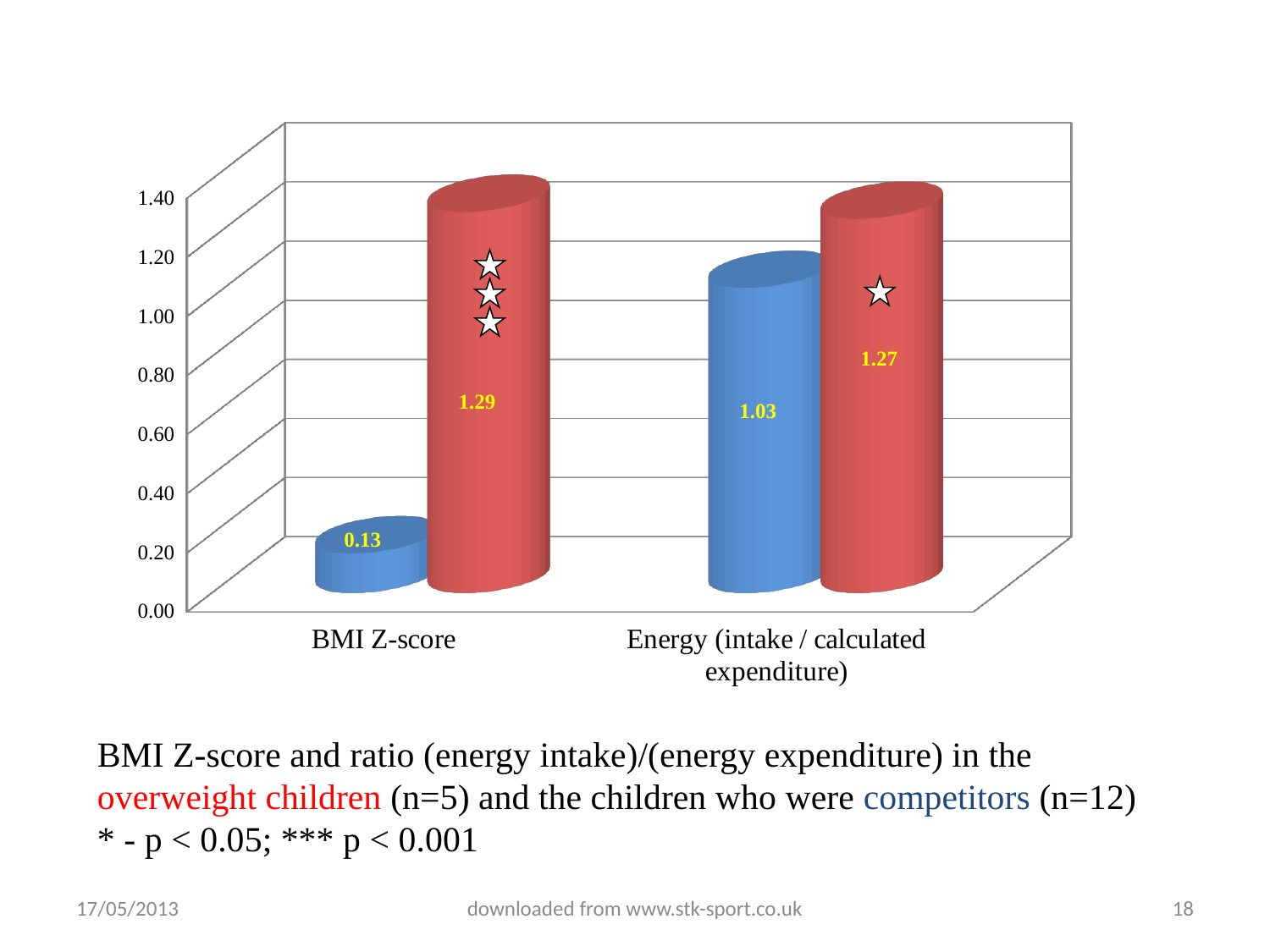
What is the value of the blue bar for BMI Z-score? 0.13 What is the value of the red bar for Energy (intake / calculated expenditure)? 1.27 What is the value of the red bar for BMI Z-score? 1.29 How many stars are drawn above the red bar for BMI Z-score? 3 How many categories are shown on the x axis? 2 What kind of chart is shown on the slide? Bar chart What is the difference between the red bar and the blue bar for Energy (intake / calculated expenditure)? 0.24 What is the difference between the red bar and the blue bar for BMI Z-score? 1.16 For BMI Z-score, which bar is larger, the blue bar or the red bar? The red bar Which bar has the lowest value in the chart? The blue bar for BMI Z-score (0.13) What is the value of the blue bar for Energy (intake / calculated expenditure)? 1.03 Which bar has the highest value in the chart? The red bar for BMI Z-score (1.29)